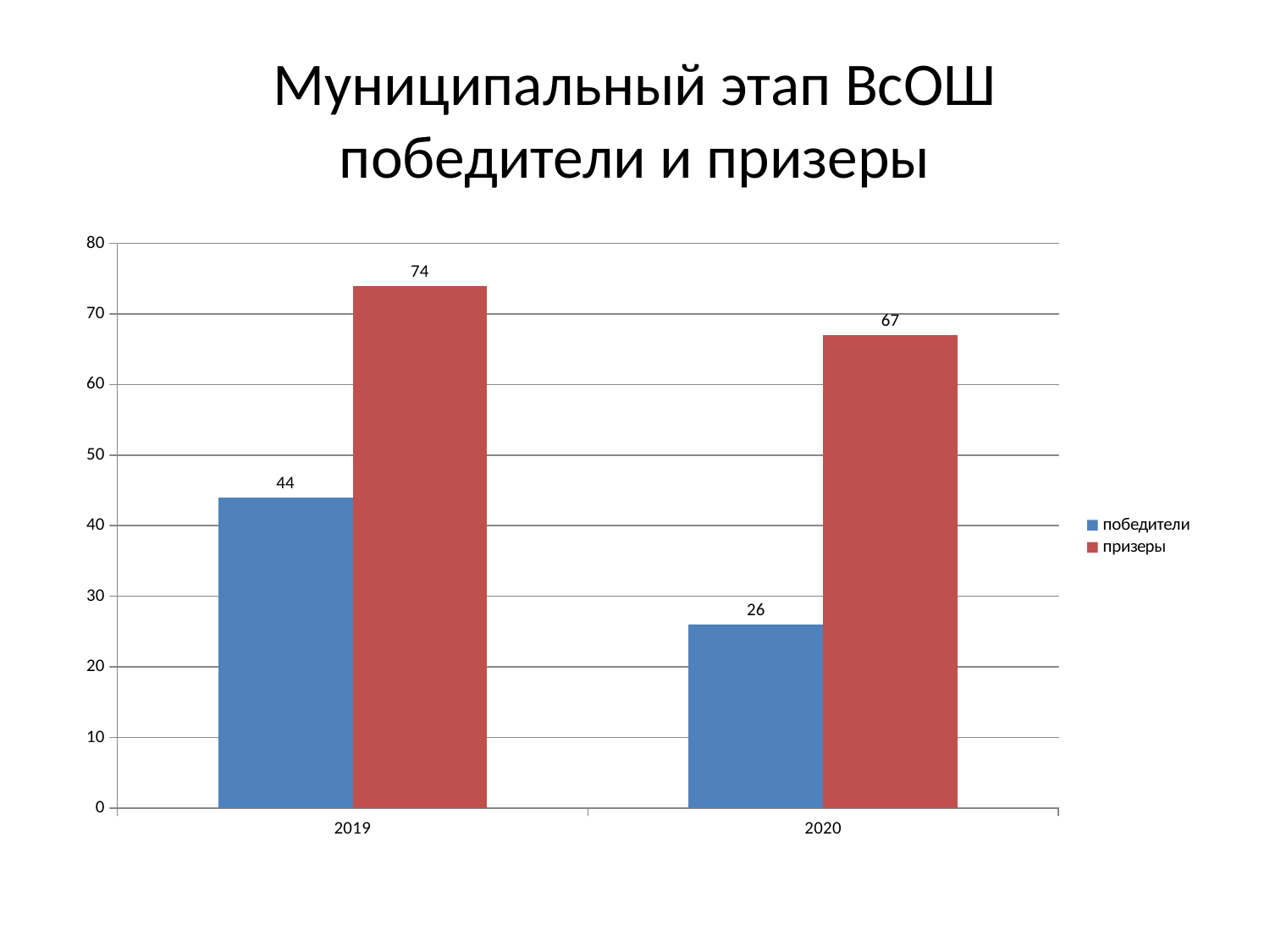
How many series does the legend list? 2 What is the difference between призеры in 2019 and призеры in 2020? 7 What is the value for победители in 2020? 26 How many years are shown on the x axis? 2 Which year has the lowest value for победители? 2020 Which is larger in 2020: победители or призеры? призеры Which year has the highest value for призеры? 2019 What is the value for победители in 2019? 44 What kind of chart is shown on the slide? bar chart Is the value for призеры in 2019 greater or less than 70? greater What is the difference between победители in 2019 and победители in 2020? 18 What is the value for призеры in 2020? 67